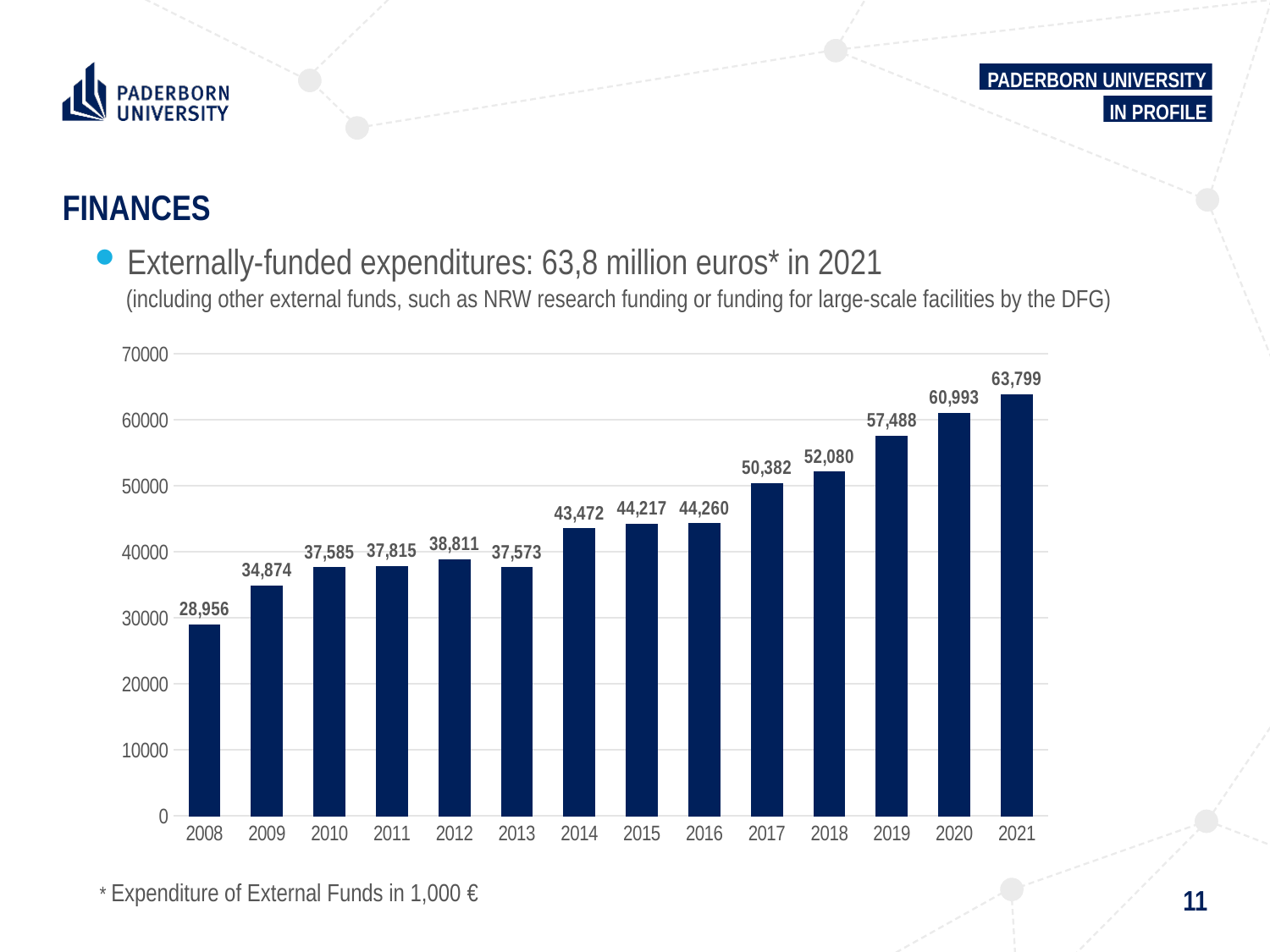
Is the value for 2019 greater or less than 50000? greater What is the difference between the values for 2021 and 2020? 2,806 What is the value shown for 2021? 63,799 What is the value shown for 2008? 28,956 According to the footnote, in what unit are the values expressed? 1,000 € Which year has the lowest value? 2008 What kind of chart is shown on the slide? Bar chart How many years are shown on the x axis? 14 What is the value shown for 2014? 43,472 Which year has the highest value? 2021 Which year has the larger value, 2012 or 2013? 2012 What is the difference between the values for 2018 and 2017? 1,698